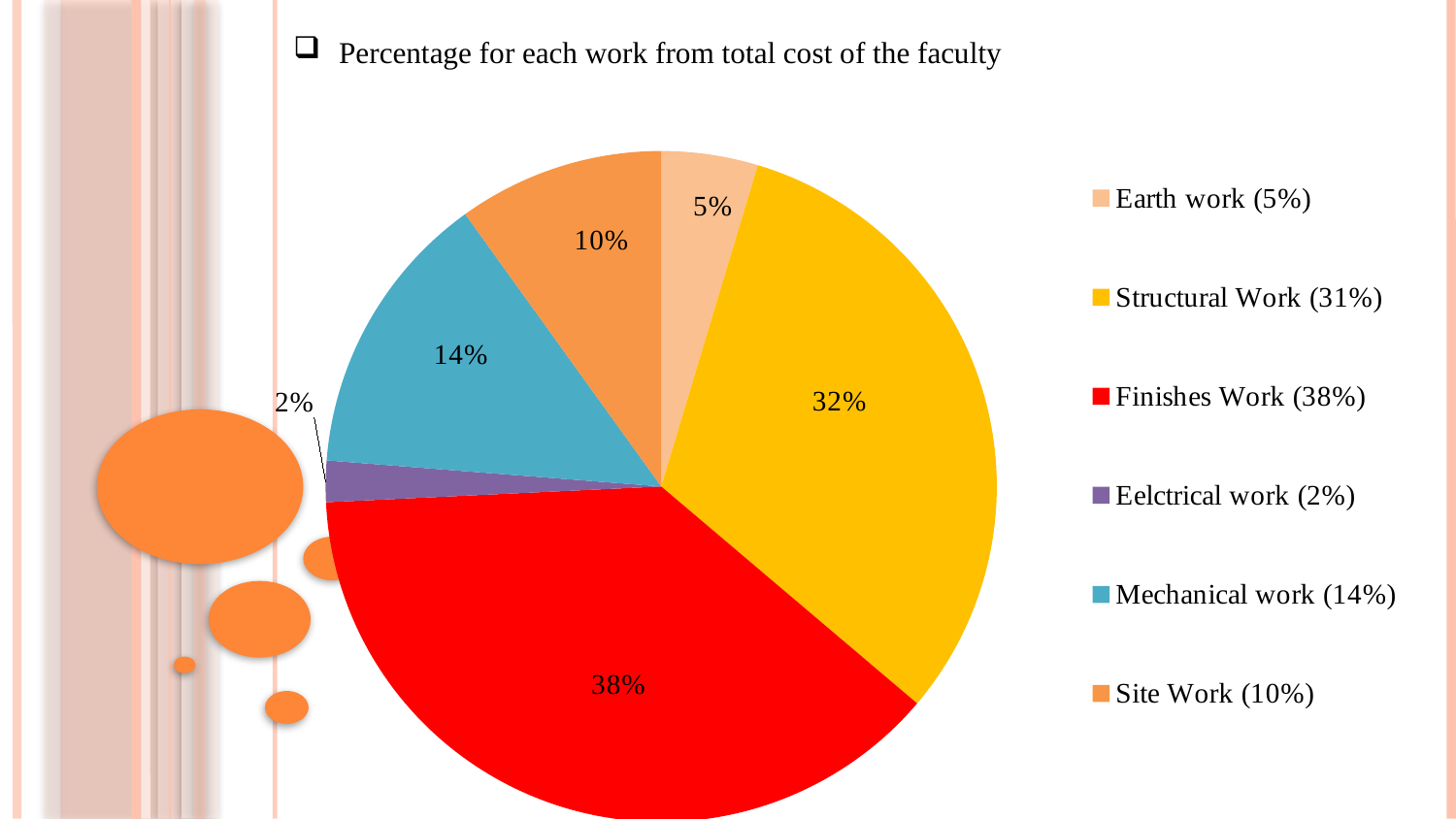
What is the difference in percentage points between Mechanical work and Site Work? 4 What percentage of the total cost is Eelctrical work? 2% How many categories of work does the pie chart show? 6 Which has a larger share of the total cost, Earth work or Site Work? Site Work What colour is the Finishes Work slice in the pie chart? red What kind of chart is shown on the slide? pie chart Which type of work has the largest share of the total cost? Finishes Work What percentage of the total cost is Earth work? 5% What percentage of the total cost is Finishes Work? 38% What percentage of the total cost is Mechanical work? 14% What percentage of the total cost is Site Work? 10% Which type of work has the smallest share of the total cost? Eelctrical work